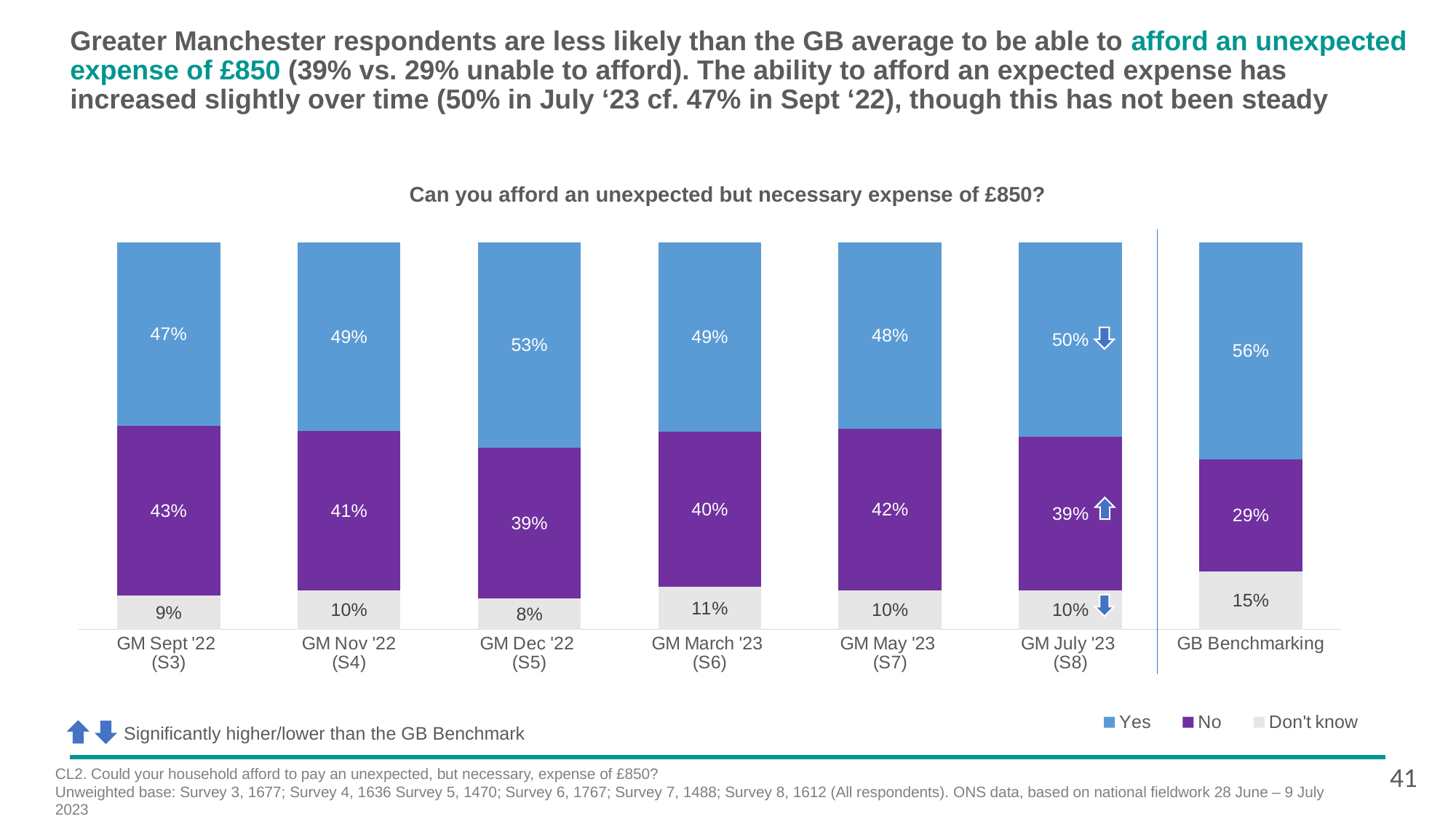
What percentage of GM Dec '22 (S5) respondents answered Yes? 53% Which is larger, the Yes value for GM Sept '22 (S3) or GM Nov '22 (S4)? GM Nov '22 (S4) What is the difference between the No value for GM July '23 (S8) and GB Benchmarking? 10% How many series does the legend list? 3 How many categories are shown on the x axis? 7 Which category has the highest Yes value? GB Benchmarking What is the Don't know value for GM March '23 (S6)? 11% Which category has the lowest Don't know value? GM Dec '22 (S5) What kind of chart is this? Stacked bar chart What is the title of the chart? Can you afford an unexpected but necessary expense of £850? What is the total of the stacked bar for GM May '23 (S7)? 100% What is the No value for GB Benchmarking? 29%